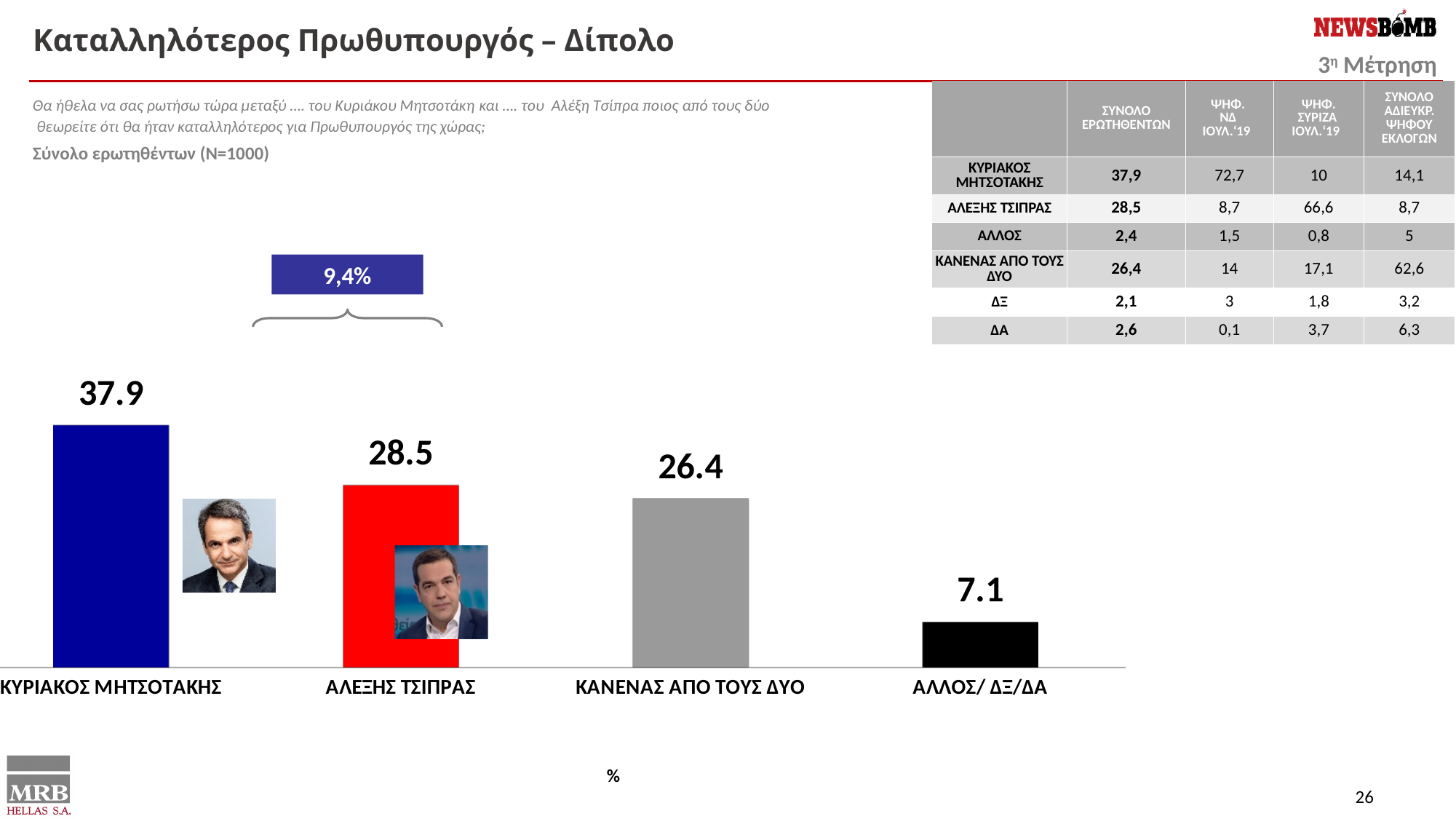
What value does the bar chart show for ΚΥΡΙΑΚΟΣ ΜΗΤΣΟΤΑΚΗΣ? 37.9 What value does the bar chart show for ΚΑΝΕΝΑΣ ΑΠΟ ΤΟΥΣ ΔΥΟ? 26.4 What colour is the bar for ΑΛΕΞΗΣ ΤΣΙΠΡΑΣ? red What value does the bar chart show for ΑΛΛΟΣ/ ΔΞ/ΔΑ? 7.1 Which is larger in the bar chart: the value for ΑΛΕΞΗΣ ΤΣΙΠΡΑΣ or the value for ΚΑΝΕΝΑΣ ΑΠΟ ΤΟΥΣ ΔΥΟ? ΑΛΕΞΗΣ ΤΣΙΠΡΑΣ What kind of chart is shown on the slide? bar chart What value does the bar chart show for ΑΛΕΞΗΣ ΤΣΙΠΡΑΣ? 28.5 What is the difference between the values for ΚΥΡΙΑΚΟΣ ΜΗΤΣΟΤΑΚΗΣ and ΑΛΕΞΗΣ ΤΣΙΠΡΑΣ in the bar chart? 9.4 Which category has the lowest bar in the chart? ΑΛΛΟΣ/ ΔΞ/ΔΑ What percentage is shown in the blue callout box above the first two bars? 9,4% Which category has the highest bar in the chart? ΚΥΡΙΑΚΟΣ ΜΗΤΣΟΤΑΚΗΣ How many categories are shown in the bar chart? 4